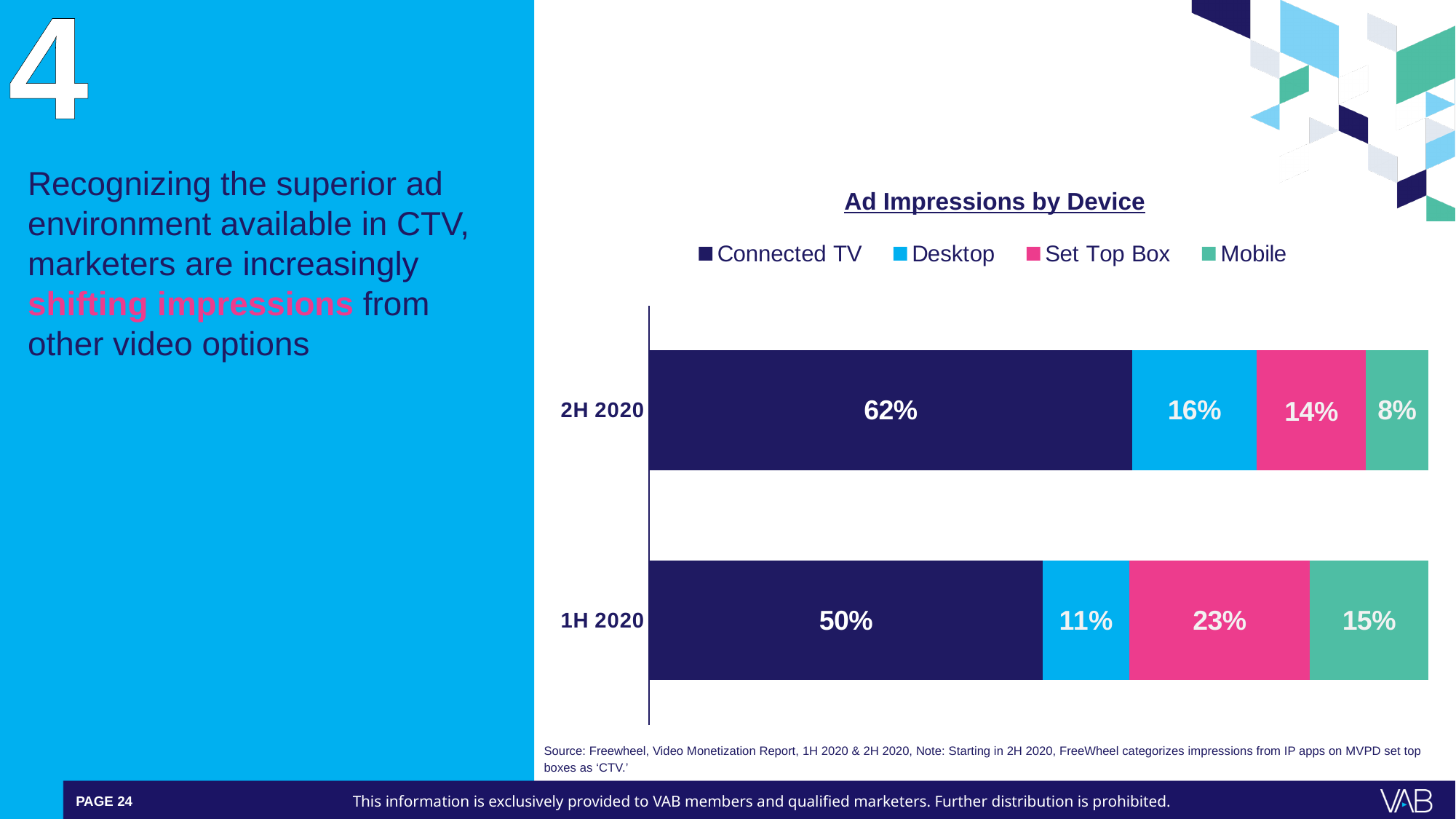
What is the Connected TV share of ad impressions in 2H 2020? 62% By how many percentage points did the Connected TV share increase from 1H 2020 to 2H 2020? 12 What is the Desktop share of ad impressions in 1H 2020? 11% What is the title of the chart? Ad Impressions by Device What is the Set Top Box share of ad impressions in 1H 2020? 23% How many periods (bars) are shown in the chart? 2 How many series does the legend list? 4 Which is larger: the Set Top Box share in 1H 2020 or in 2H 2020? 1H 2020 Which device has the smallest share of ad impressions in 2H 2020? Mobile Which device has the largest share of ad impressions in 1H 2020? Connected TV What is the Mobile share of ad impressions in 2H 2020? 8% What type of chart is shown on the slide? Stacked bar chart